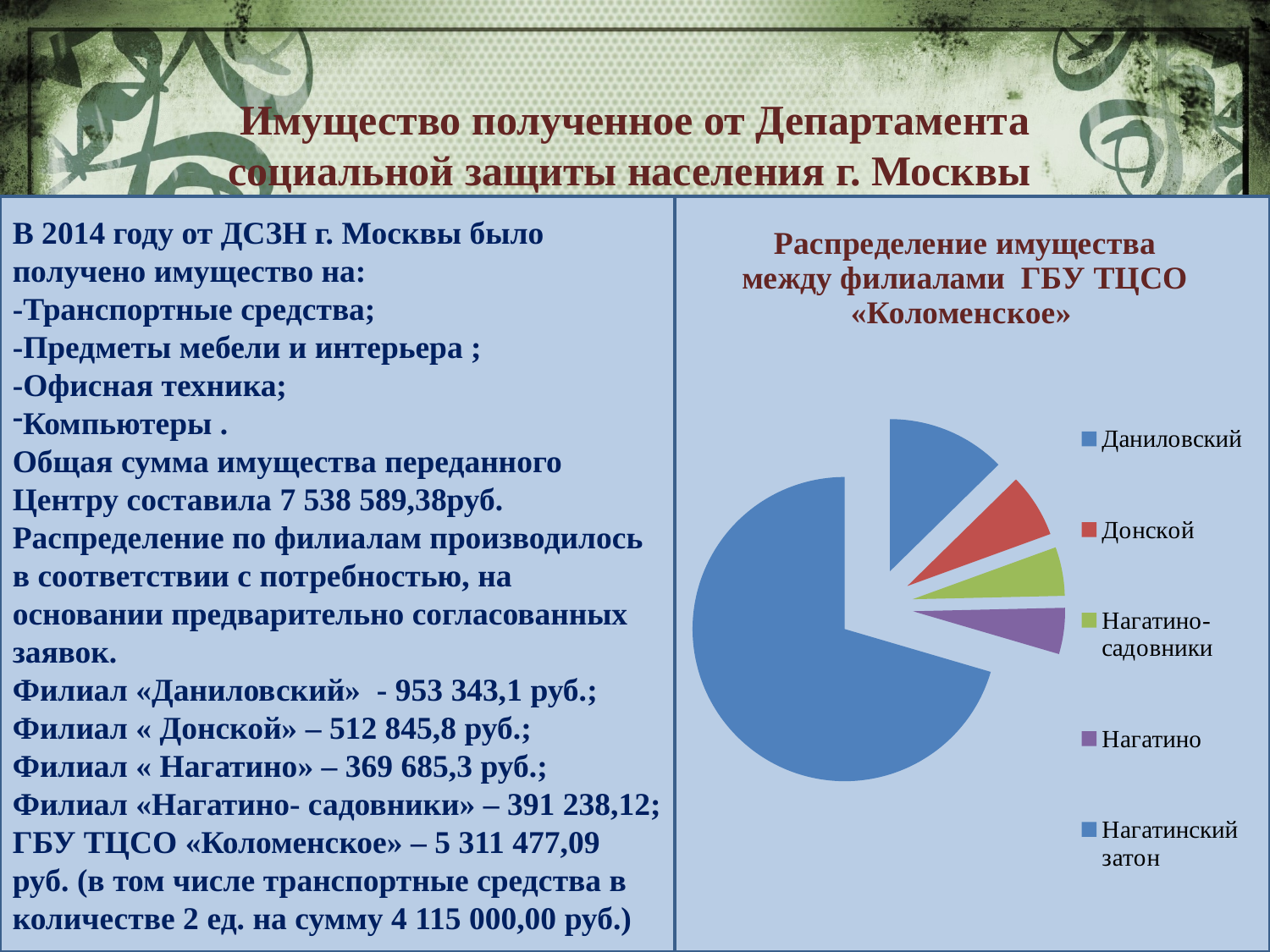
What colour is the Донской slice in the pie chart? red Does the Нагатинский затон slice take up more or less than half of the pie? more Which category has the largest slice in the pie chart? Нагатинский затон Which slice is larger, Даниловский or Донской? Даниловский Which slice is larger, Донской or Нагатино? Донской Which slice is larger, Нагатинский затон or Даниловский? Нагатинский затон How many entries does the legend of the pie chart list? 5 What is the title of the pie chart? Распределение имущества между филиалами ГБУ ТЦСО «Коломенское» How many slices does the pie chart have? 5 What kind of chart is shown on the slide? pie chart